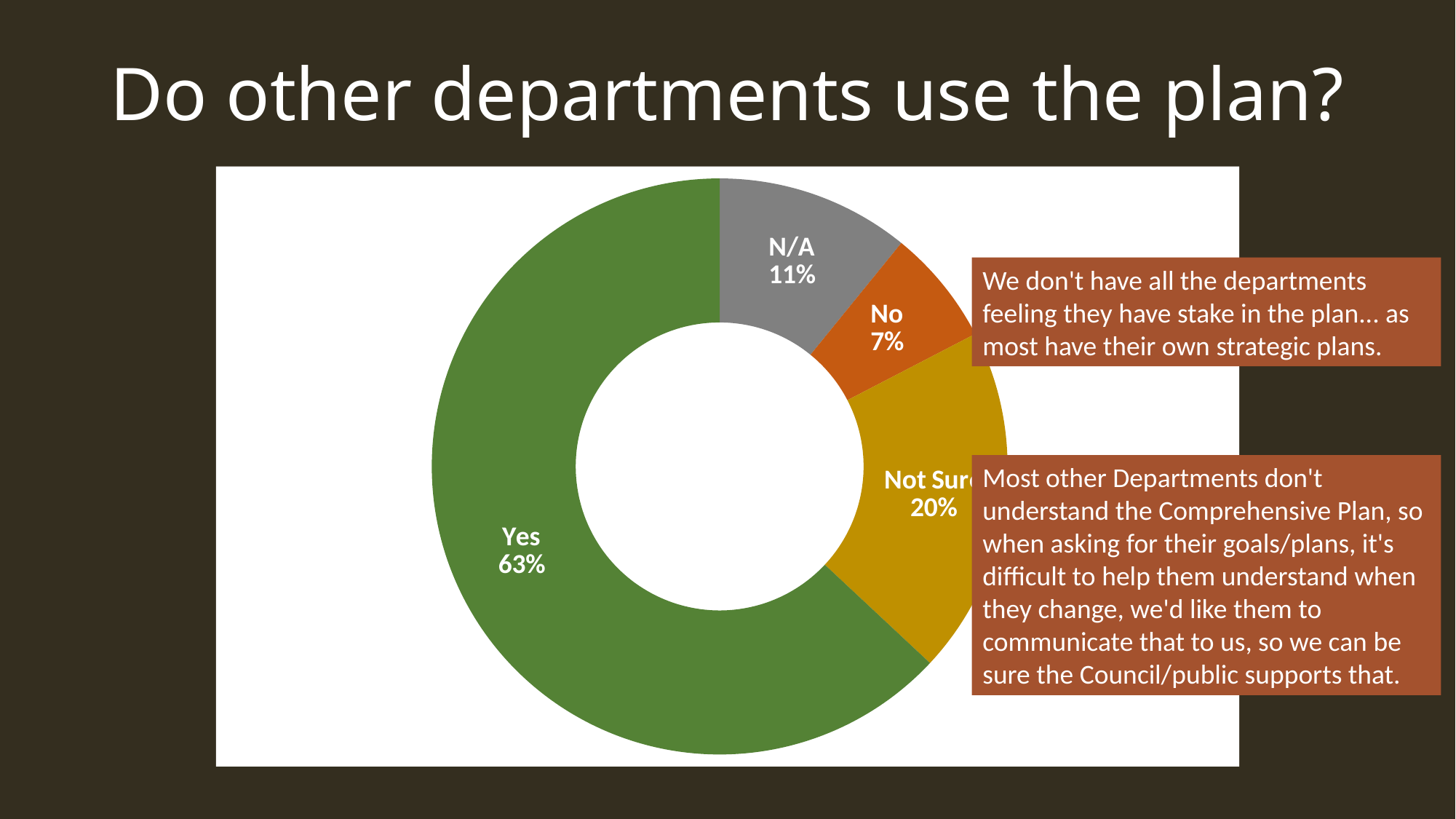
What is the combined share of "No" and "Not Sure"? 27% Which category has the smallest share of the chart? No What is the difference in percentage points between "Yes" and "Not Sure"? 43 What percentage of responses are "N/A"? 11% Which is larger, the share for "N/A" or the share for "No"? N/A What kind of chart is shown on the slide? Doughnut (pie) chart What colour is the "Yes" segment of the chart? Green How many categories are shown in the chart? 4 What percentage of responses are "Yes"? 63% What percentage of responses are "No"? 7% What percentage of responses are "Not Sure"? 20% Which category has the largest share of the chart? Yes